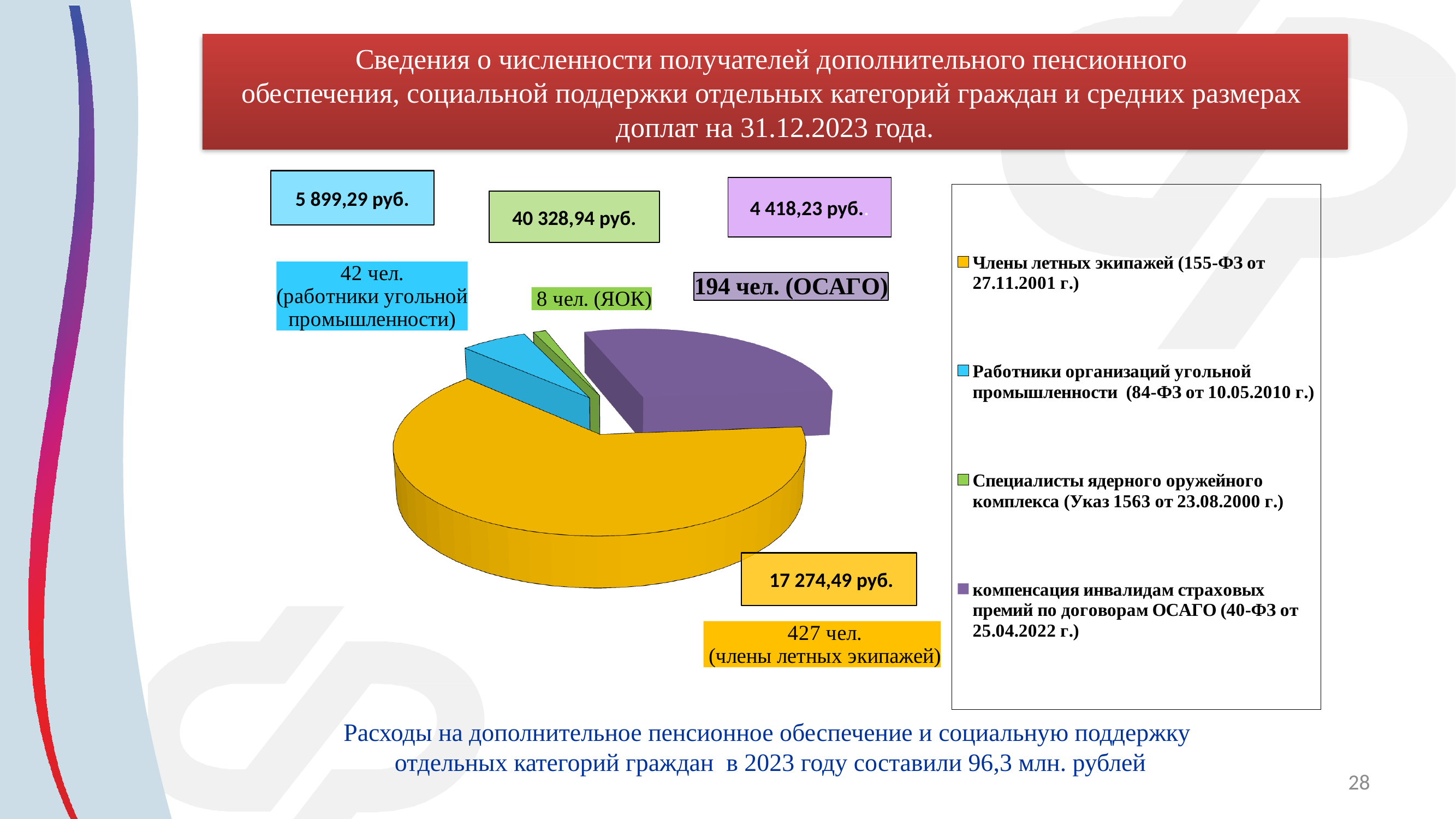
What kind of chart is shown on the slide? pie chart How many entries does the legend of the pie chart list? 4 How many slices does the pie chart have? 4 What average payment amount is shown in the green box for ЯОК? 40 328,94 руб. How many recipients are shown for члены летных экипажей? 427 чел. What is the difference in the number of recipients between члены летных экипажей and ОСАГО? 233 чел. Which category has the largest slice of the pie chart? Члены летных экипажей Which has more recipients: работники угольной промышленности or ОСАГО? ОСАГО How many recipients are shown for ОСАГО (компенсация инвалидам страховых премий)? 194 чел. How many recipients are shown for ЯОК (специалисты ядерного оружейного комплекса)? 8 чел. How many recipients are shown for работники угольной промышленности? 42 чел. Which category has the smallest slice of the pie chart? Специалисты ядерного оружейного комплекса (ЯОК)